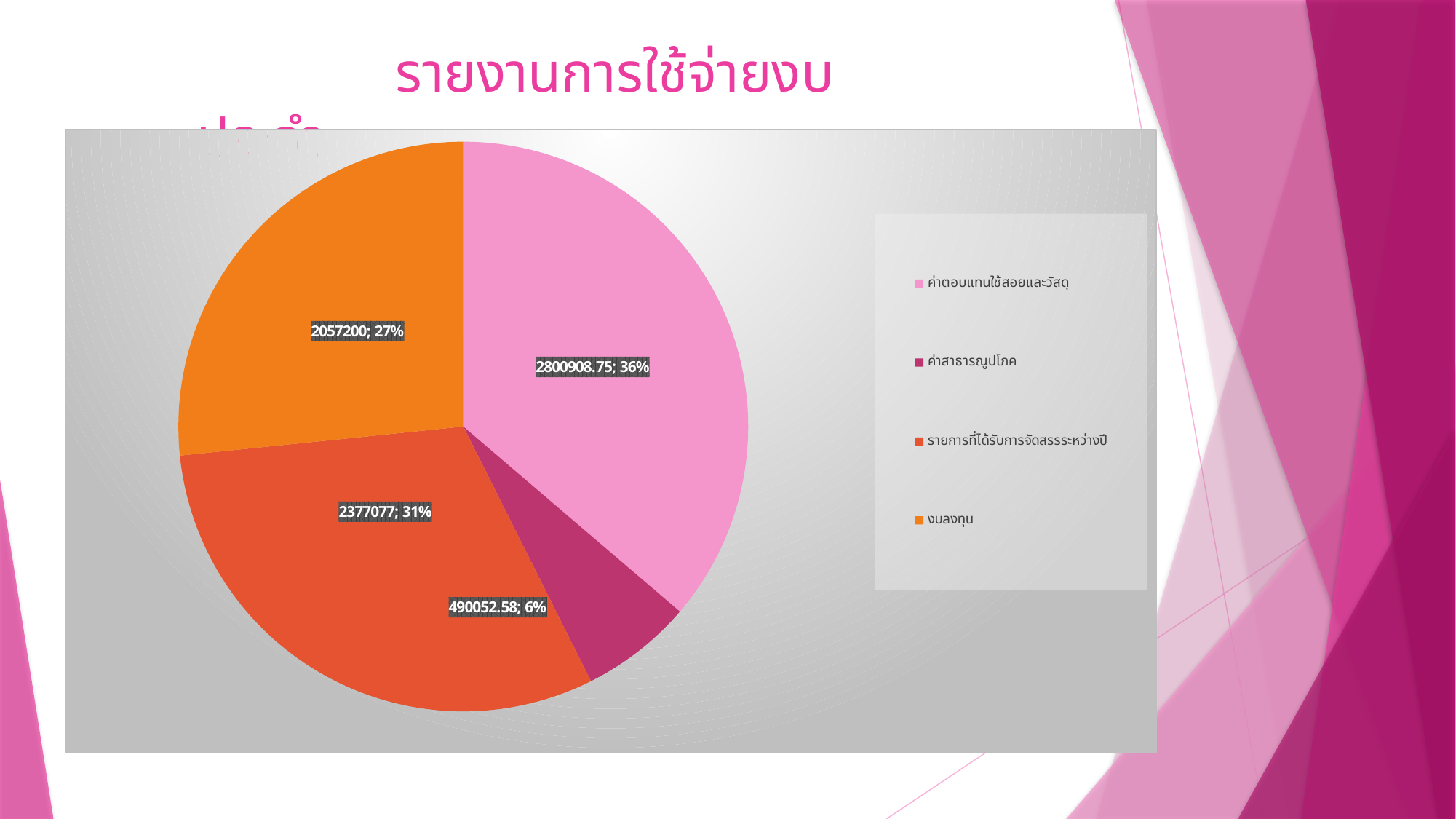
Which category has the largest slice of the pie? ค่าตอบแทนใช้สอยและวัสดุ Which category has the smallest slice of the pie? ค่าสาธารณูปโภค Which is larger, the value for รายการที่ได้รับการจัดสรรระหว่างปี or the value for งบลงทุน? รายการที่ได้รับการจัดสรรระหว่างปี How many slices does the pie chart have? 4 How many entries does the legend list? 4 What value is shown for รายการที่ได้รับการจัดสรรระหว่างปี? 2377077 What value is shown for ค่าตอบแทนใช้สอยและวัสดุ? 2800908.75 What percentage share of the pie does งบลงทุน have? 27% What percentage share of the pie does ค่าตอบแทนใช้สอยและวัสดุ have? 36% What value is shown for ค่าสาธารณูปโภค? 490052.58 What kind of chart is shown on the slide? pie chart What value is shown for งบลงทุน? 2057200